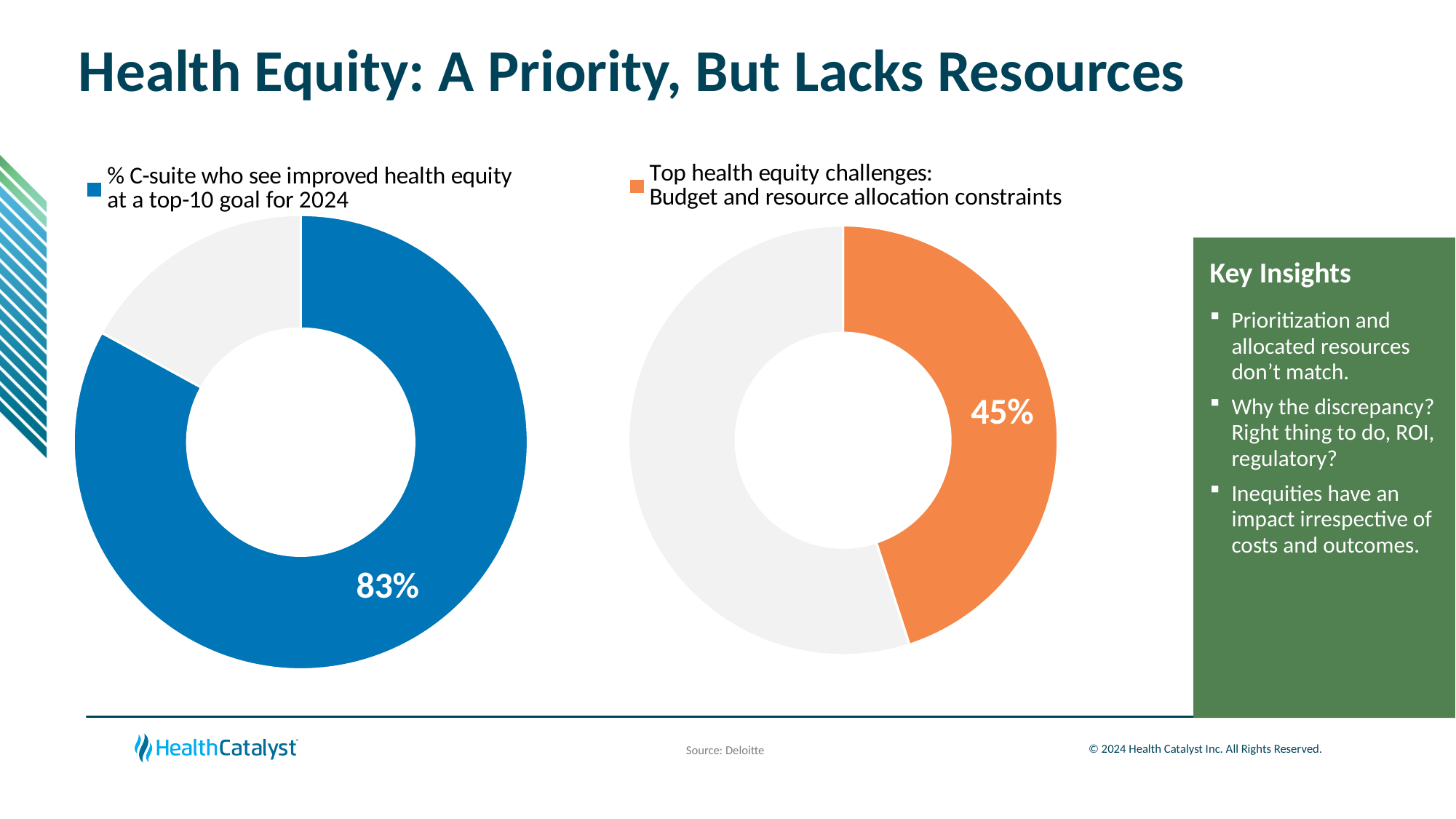
Which is larger: the 83% value in the left chart or the 45% value in the right chart? The 83% value in the left chart What is the difference in percentage points between the left chart's labelled value and the right chart's labelled value? 38 percentage points What colour is the labelled slice in the right chart? Orange In the left chart, what percentage of C-suite see improved health equity as a top-10 goal for 2024? 83% What kind of chart is the left chart on the slide? Pie (donut) chart In the right chart, what percentage is shown for budget and resource allocation constraints as a top health equity challenge? 45% How many slices does the left chart have? 2 In the right chart, what share of the pie does the orange slice represent? 45% What kind of chart is the right chart on the slide? Pie (donut) chart How many entries does the legend of the right chart list? 1 In the left chart, what share of the pie does the blue slice represent? 83% What is the legend entry for the left chart? % C-suite who see improved health equity at a top-10 goal for 2024